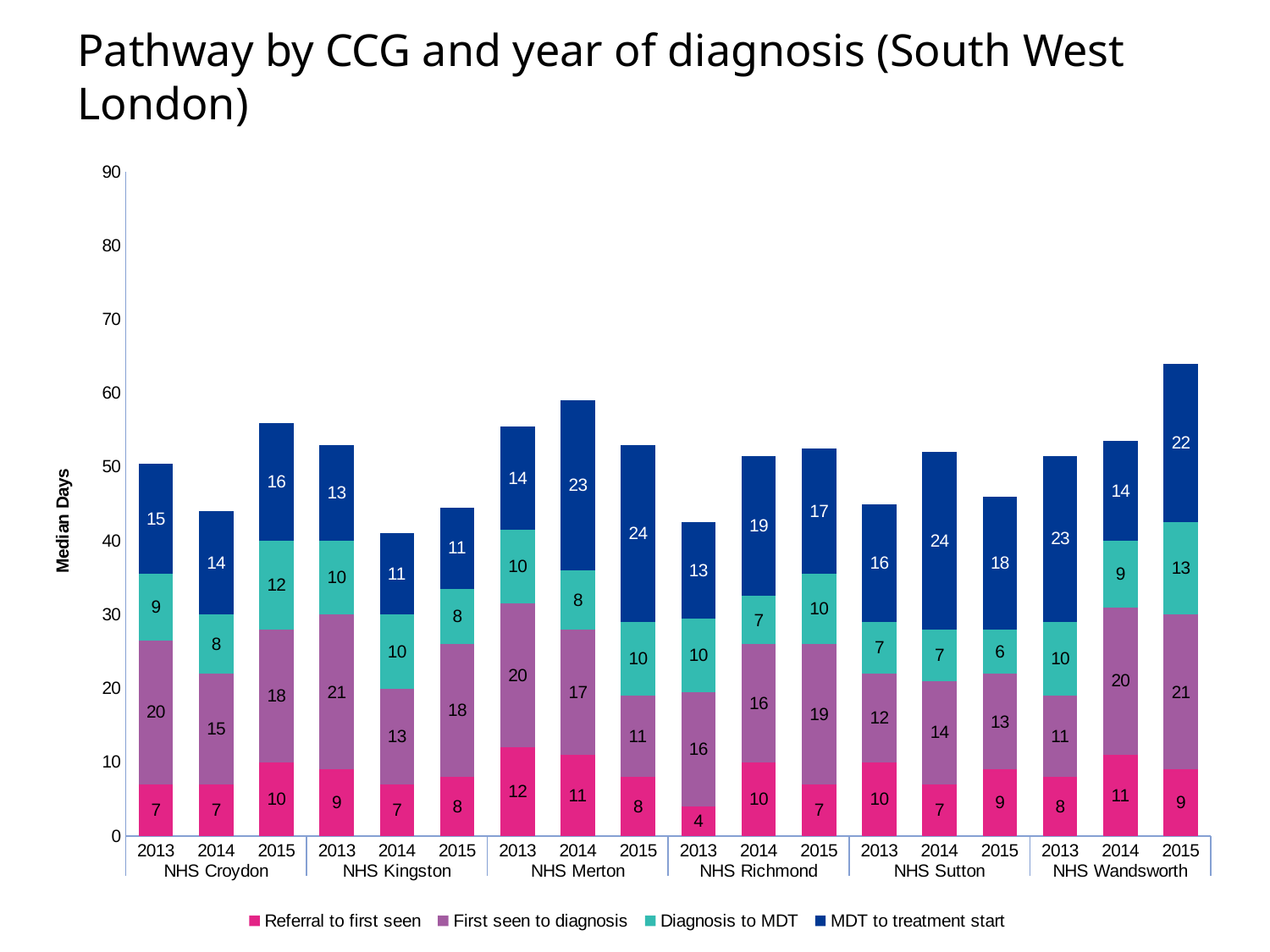
Which CCG and year has the highest Referral to first seen value? NHS Merton 2013 Is the total height of the bar for NHS Wandsworth 2015 greater or less than 60? greater What is the total of the stacked bar for NHS Merton in 2014? 59 What is the label on the y axis? Median Days Which has the larger MDT to treatment start value: NHS Sutton 2014 or NHS Wandsworth 2014? NHS Sutton 2014 Which CCG and year has the lowest Diagnosis to MDT value? NHS Sutton 2015 What kind of chart is shown on the slide? Stacked bar chart How many CCGs are shown along the x axis? 6 What is the MDT to treatment start value for NHS Merton in 2014? 23 What is the difference between the First seen to diagnosis values for NHS Croydon in 2013 and 2014? 5 What is the Referral to first seen value for NHS Richmond in 2013? 4 How many series does the legend list? 4